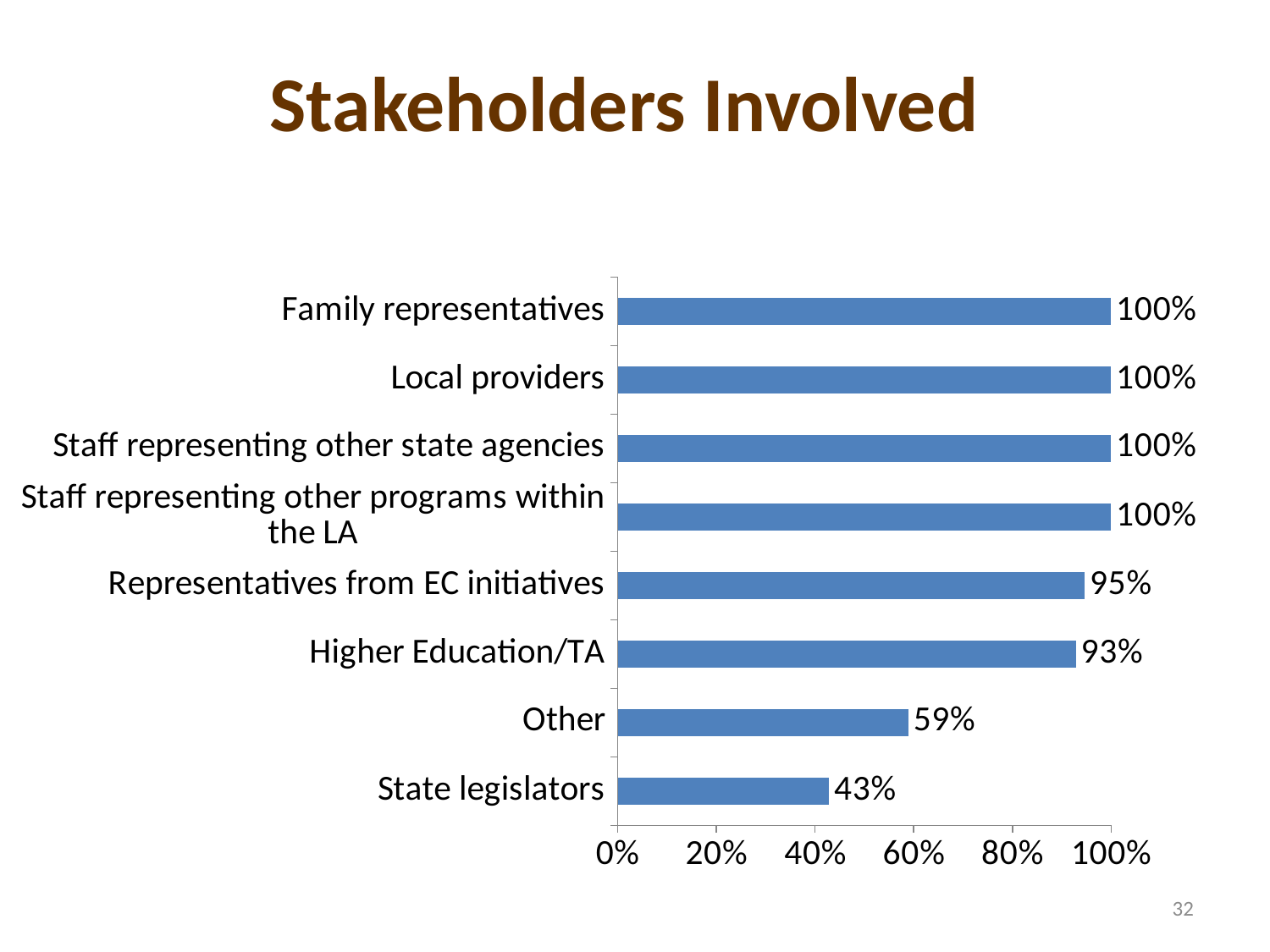
What is the difference between the values for Family representatives and Higher Education/TA? 7% What is the value for Representatives from EC initiatives? 95% What is the difference between the values for Other and State legislators? 16% Which category has the lowest value? State legislators How many categories have a value of 100%? 4 Which is larger, the value for Representatives from EC initiatives or the value for Higher Education/TA? Representatives from EC initiatives What is the value for State legislators? 43% What is the value for Higher Education/TA? 93% What is the value for Other? 59% What kind of chart is shown on the slide? Bar chart How many categories are shown in the chart? 8 Is the value for Other greater or less than 40%? greater